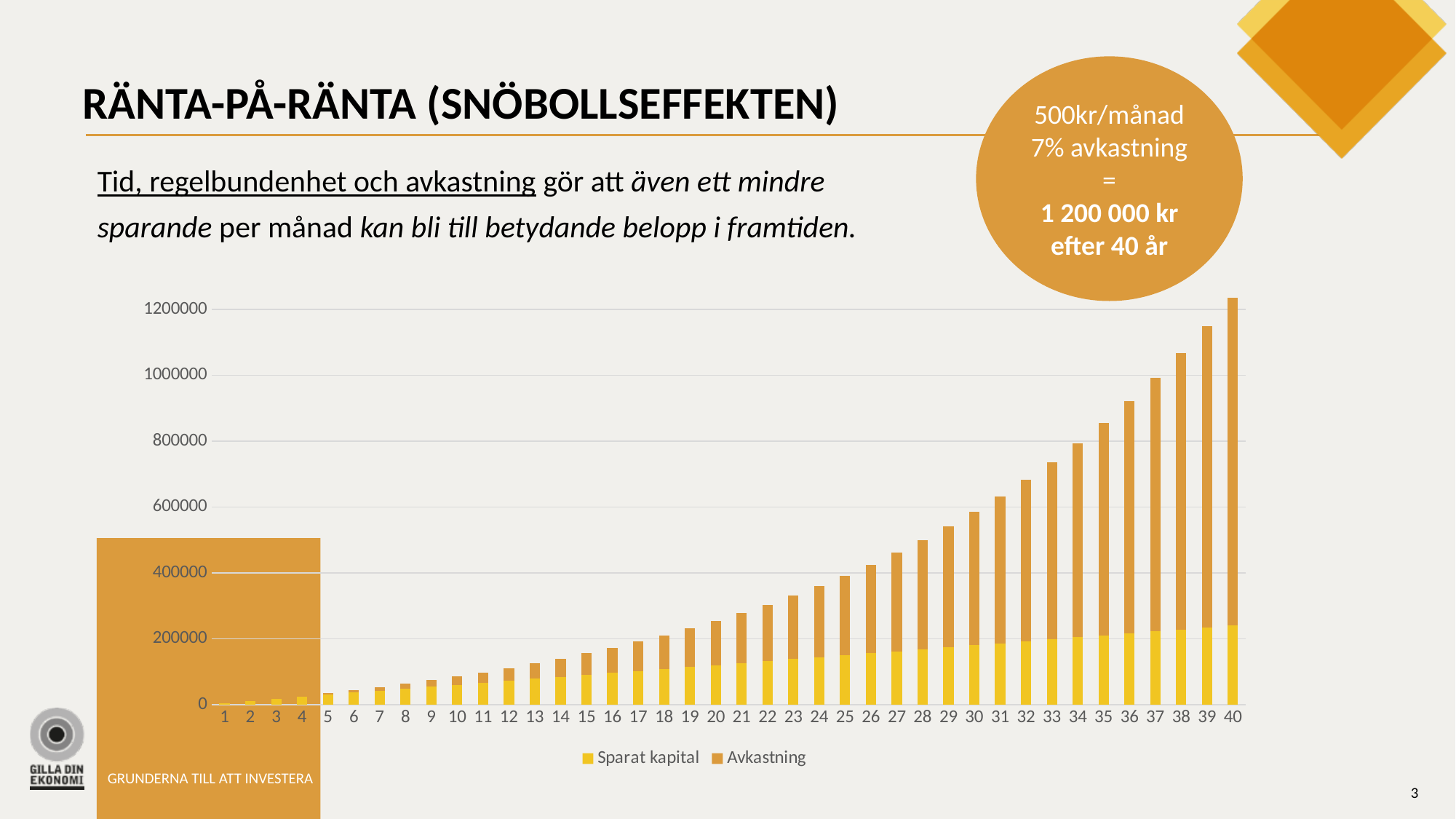
Which year has the highest total bar in the chart? 40 What are the two series named in the chart legend? Sparat kapital and Avkastning Is the total value for year 38 greater or less than 1000000? greater Which is larger, the total bar for year 25 or the total bar for year 15? Year 25 Which year has the lowest total bar in the chart? 1 Is the total value for year 20 greater or less than 200000? greater How many categories (years) are shown along the x axis of the chart? 40 How many series does the chart legend list? 2 What kind of chart is shown on the slide? Bar chart Is the total value for year 10 greater or less than 200000? less Do the total bar values rise or fall as the years increase along the x axis? Rise